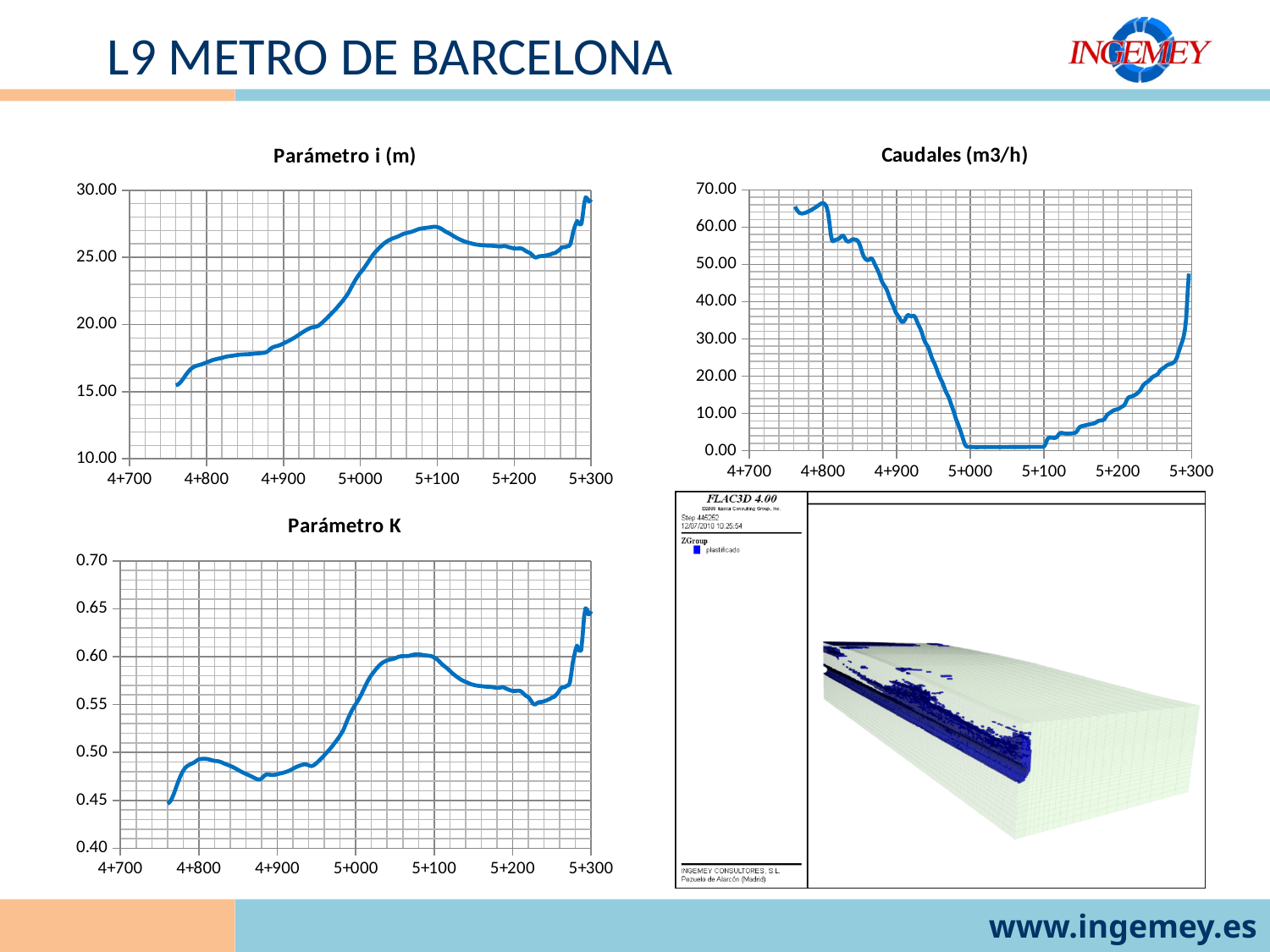
In the 'Parámetro i (m)' chart, is the value at 4+800 greater or less than 20.00? less In the 'Parámetro K' chart, is the value at 4+900 greater or less than 0.50? less In the 'Parámetro i (m)' chart, is the value at 5+100 greater or less than 25.00? greater What is the highest value shown on the y axis of the 'Caudales (m3/h)' chart? 70.00 In the 'Parámetro i (m)' chart, do the values rise or fall between 4+900 and 5+100? rise In the 'Caudales (m3/h)' chart, do the values rise or fall between 4+800 and 5+000? fall How many line charts are shown on the slide? 3 What kind of chart is 'Parámetro i (m)'? line chart In the 'Caudales (m3/h)' chart, which is larger, the value at 4+800 or the value at 5+000? 4+800